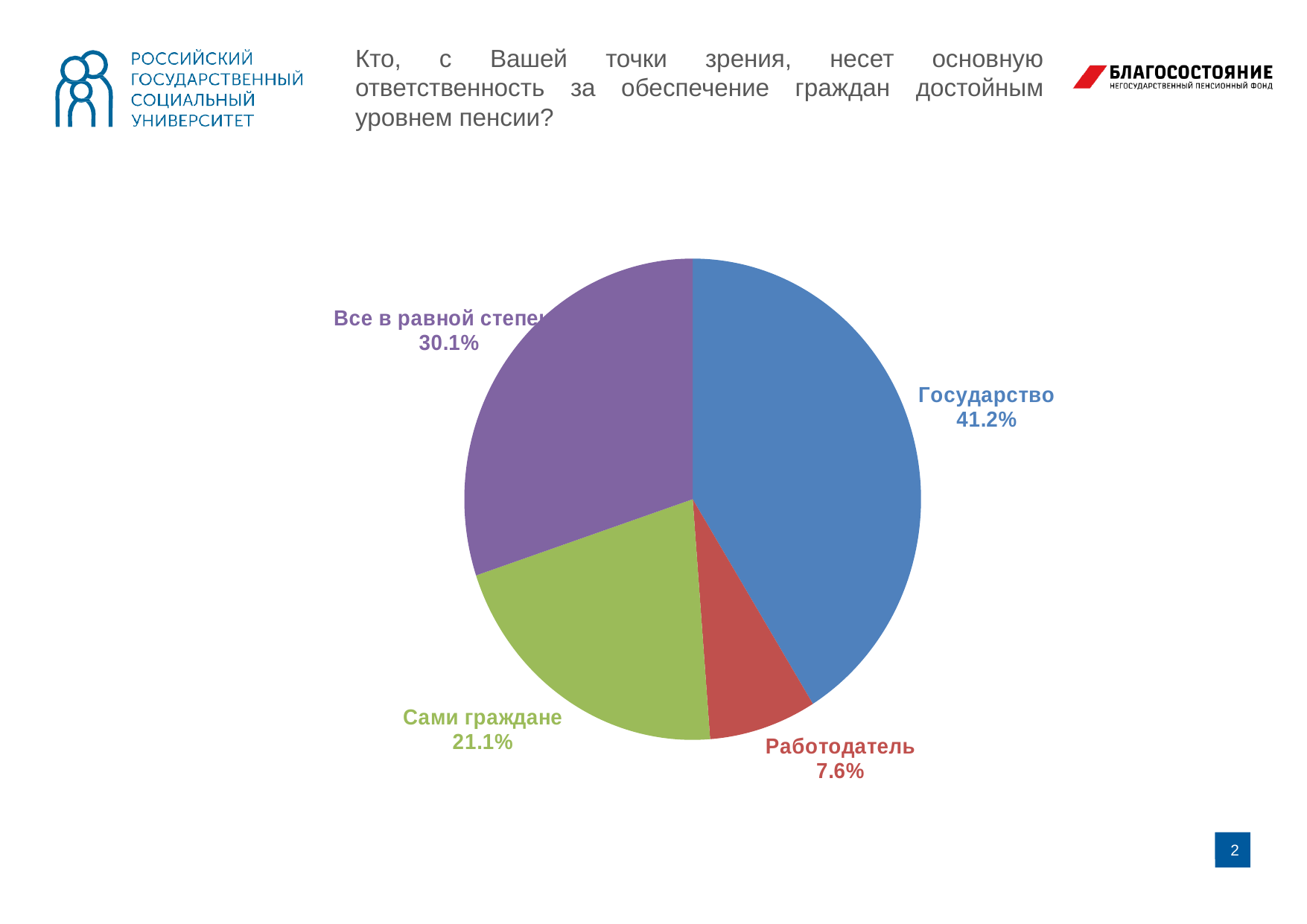
How many answer options (slices) does the pie chart show? 4 Which answer option has the smallest slice of the pie? Работодатель Which answer option has the largest slice of the pie? Государство What is the difference in percentage points between «Государство» and «Все в равной степени»? 11.1 What share of respondents chose «Сами граждане»? 21.1% What share of respondents chose «Государство»? 41.2% Which is larger: the share for «Сами граждане» or for «Все в равной степени»? Все в равной степени What share of respondents chose «Работодатель»? 7.6% What colour is the slice for «Работодатель»? Red What type of chart is shown on the slide? Pie chart What share of respondents chose «Все в равной степени»? 30.1% What is the difference in percentage points between «Сами граждане» and «Работодатель»? 13.5